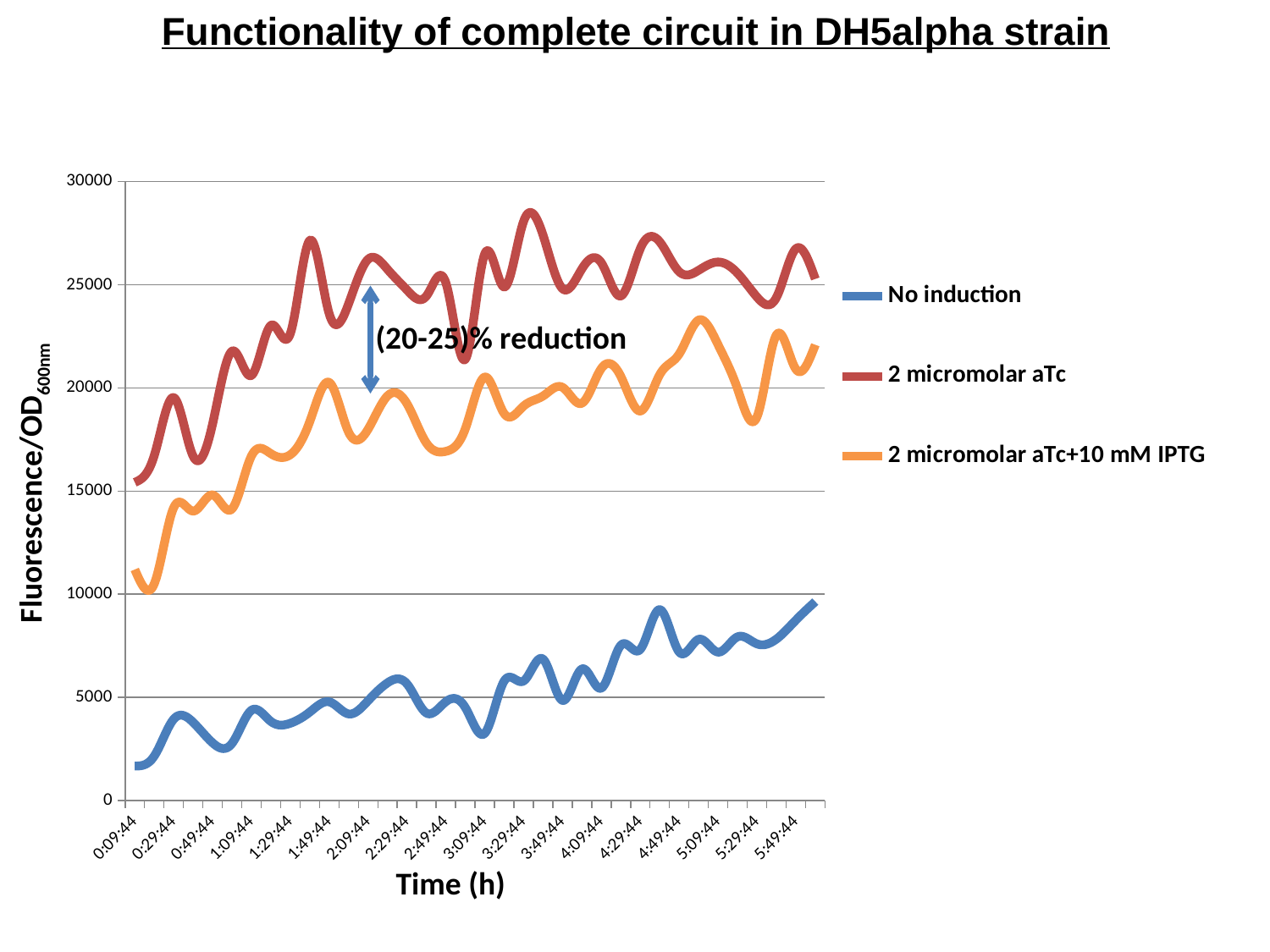
At 4:49:44, which series has the larger value: 2 micromolar aTc or 2 micromolar aTc+10 mM IPTG? 2 micromolar aTc What is the title of the chart? Functionality of complete circuit in DH5alpha strain What kind of chart is shown on the slide? line chart Does the No induction series generally rise or fall over time? rise What is the label of the x axis? Time (h) Which series has the highest fluorescence values throughout the chart? 2 micromolar aTc Which series has the lowest fluorescence values throughout the chart? No induction Is the value for 2 micromolar aTc+10 mM IPTG at 0:09:44 greater or less than 15000? less How many series does the legend list? 3 Is the value for No induction at 0:09:44 greater or less than 5000? less Is the value for 2 micromolar aTc at 3:09:44 greater or less than 20000? greater What percentage reduction does the annotation on the chart indicate between the 2 micromolar aTc and 2 micromolar aTc+10 mM IPTG series? (20-25)% reduction